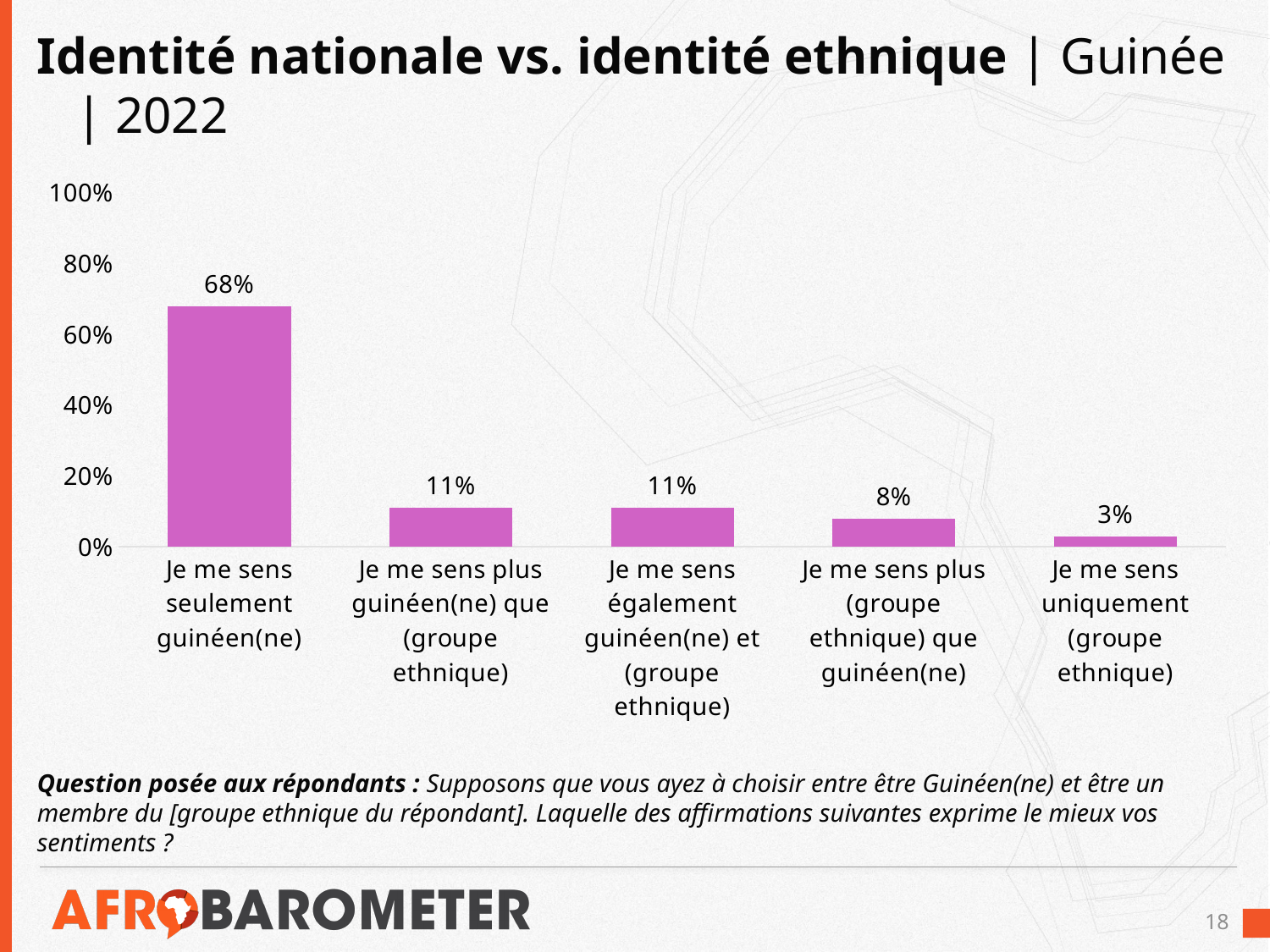
What is the title of the chart? Identité nationale vs. identité ethnique | Guinée | 2022 Which category has the lowest value? Je me sens uniquement (groupe ethnique) What kind of chart is shown on the slide? Bar chart What is the difference between the values for "Je me sens seulement guinéen(ne)" and "Je me sens plus guinéen(ne) que (groupe ethnique)"? 57% How many categories are shown on the chart? 5 What is the value for "Je me sens également guinéen(ne) et (groupe ethnique)"? 11% Which category has the highest value? Je me sens seulement guinéen(ne) What is the value for "Je me sens plus (groupe ethnique) que guinéen(ne)"? 8% Which is larger, the value for "Je me sens plus (groupe ethnique) que guinéen(ne)" or the value for "Je me sens uniquement (groupe ethnique)"? Je me sens plus (groupe ethnique) que guinéen(ne) Is the value for "Je me sens seulement guinéen(ne)" greater or less than 60%? greater What is the value for "Je me sens uniquement (groupe ethnique)"? 3% What is the value for "Je me sens seulement guinéen(ne)"? 68%